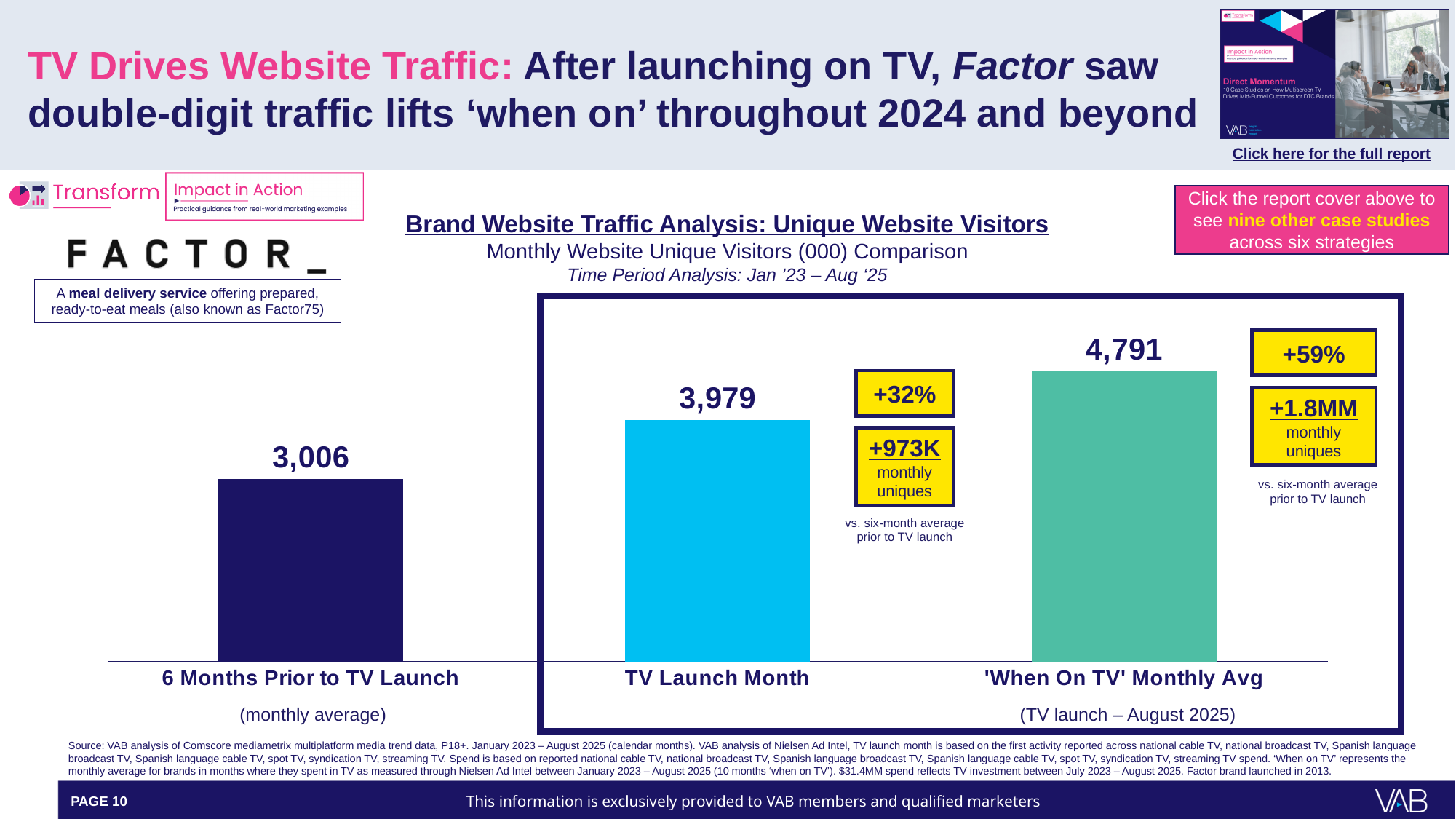
What kind of chart is shown? Bar chart Which category has the lowest value? 6 Months Prior to TV Launch What is the value for '6 Months Prior to TV Launch'? 3,006 Which category has the highest value? 'When On TV' Monthly Avg What is the difference between the 'When On TV' Monthly Avg and the 6 Months Prior to TV Launch values? 1,785 What is the difference between the TV Launch Month and the 6 Months Prior to TV Launch values? 973 Which is larger, the value for TV Launch Month or for 'When On TV' Monthly Avg? 'When On TV' Monthly Avg Do the values rise or fall from left to right across the categories? Rise How many categories are shown in the chart? 3 What is the value for ''When On TV' Monthly Avg'? 4,791 What percentage lift is shown for the 'When On TV' Monthly Avg versus the six-month average prior to TV launch? +59% What is the value for 'TV Launch Month'? 3,979